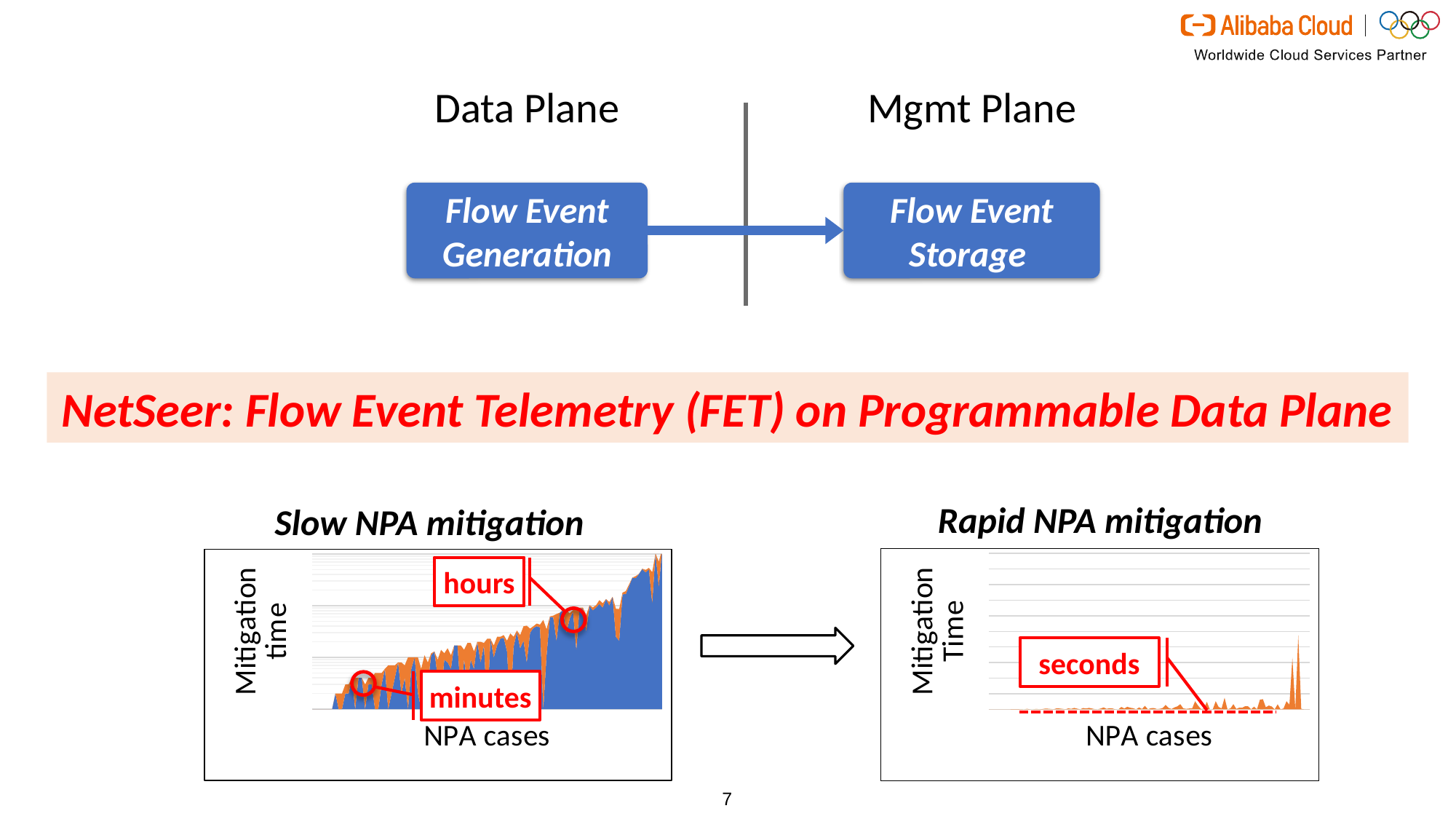
In the "Slow NPA mitigation" chart, do the mitigation time values rise or fall along the x axis? rise What kind of chart is the "Rapid NPA mitigation" chart? area chart What kind of chart is the "Slow NPA mitigation" chart? area chart What is the x-axis label of the "Rapid NPA mitigation" chart? NPA cases What unit of mitigation time is annotated on the "Rapid NPA mitigation" chart? seconds